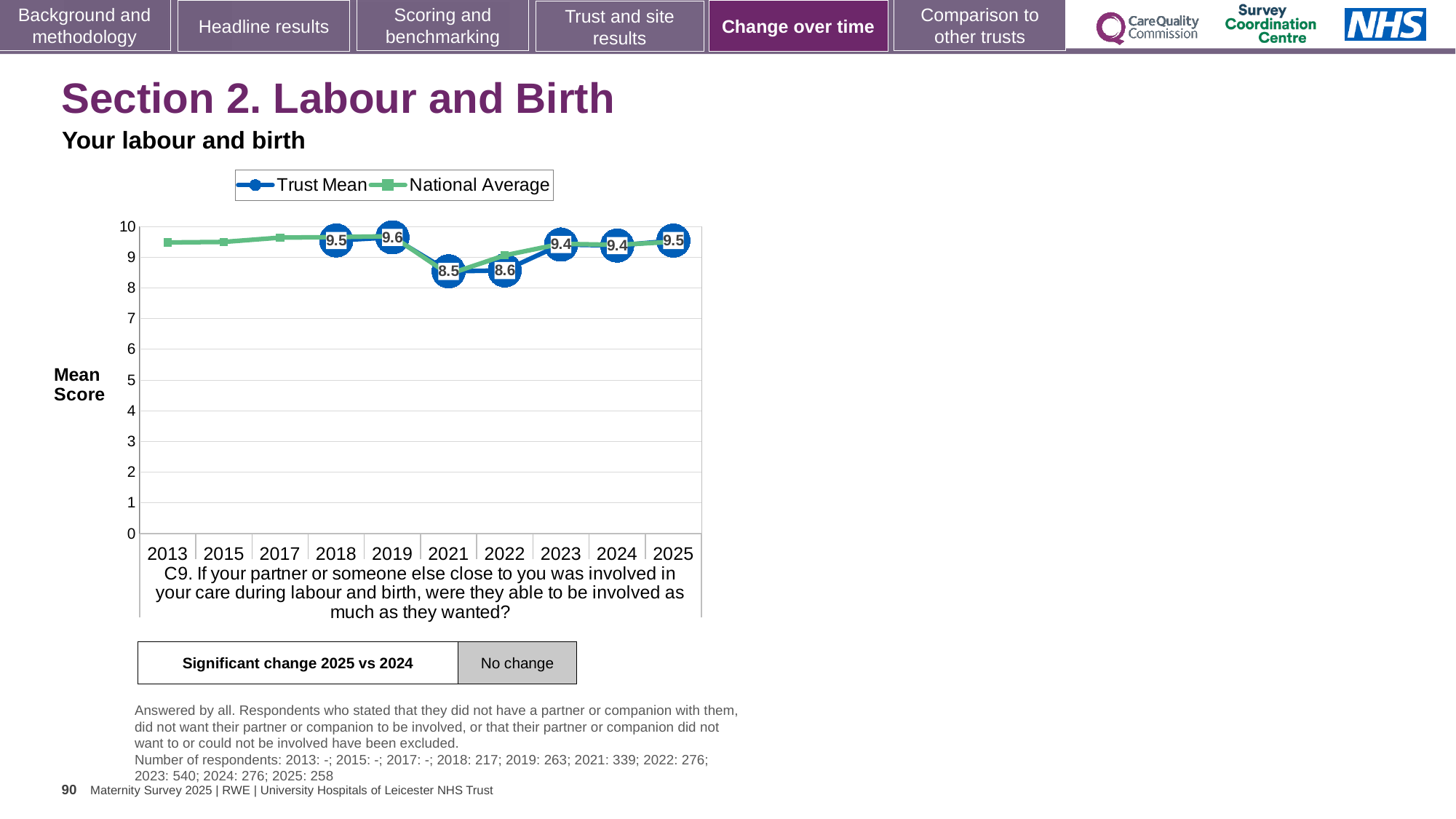
What is the Trust Mean value for 2025? 9.5 Did the Trust Mean rise or fall from 2019 to 2021? fall Which is larger, the Trust Mean in 2022 or in 2023? 2023 How many years are shown on the x axis? 10 In which year is the Trust Mean lowest? 2021 Is the National Average value for 2013 greater or less than 9? greater What is the Trust Mean value for 2021? 8.5 What is the Trust Mean value for 2019? 9.6 What is the difference between the Trust Mean in 2019 and in 2021? 1.1 How many series does the legend list? 2 What kind of chart is shown on the slide? Line chart In which year is the Trust Mean highest? 2019